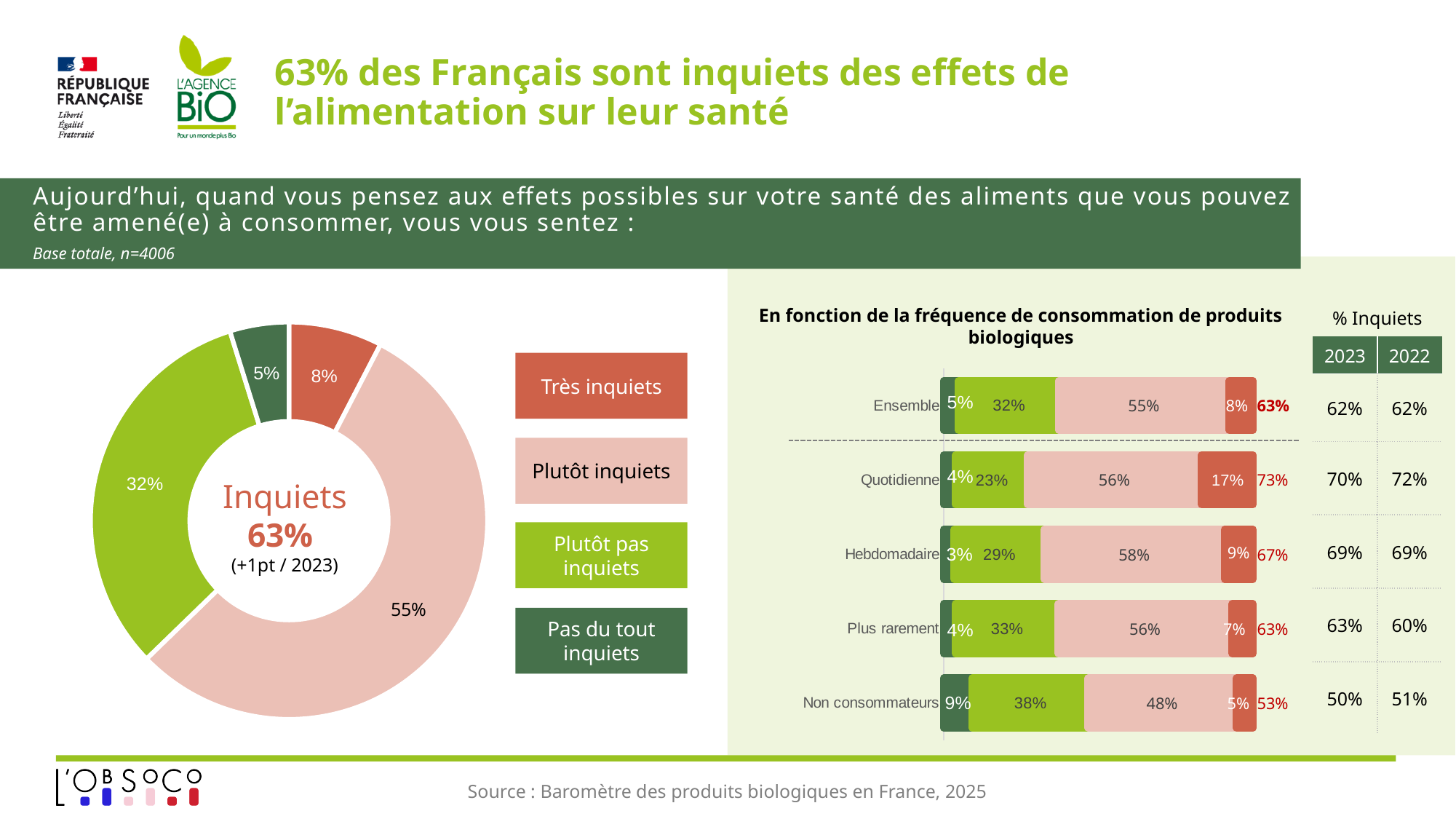
In the donut chart on the left, what share of respondents are 'Plutôt inquiets'? 55% In the donut chart on the left, what share of respondents are 'Pas du tout inquiets'? 5% In the stacked bar chart on the right, what is the 'Très inquiets' value for 'Quotidienne'? 17% In the stacked bar chart on the right, which category has the highest total '% Inquiets' (red figure)? Quotidienne What kind of chart is shown on the left side of the slide? Donut (pie) chart In the donut chart on the left, which category has the largest share? Plutôt inquiets In the stacked bar chart on the right, is the total '% Inquiets' larger for 'Hebdomadaire' or for 'Non consommateurs'? Hebdomadaire What kind of chart is shown on the right side of the slide, under 'En fonction de la fréquence de consommation de produits biologiques'? Stacked bar chart In the stacked bar chart on the right, what is the 'Plutôt pas inquiets' value for 'Non consommateurs'? 38% In the stacked bar chart on the right, how many categories (rows) are plotted? 5 In the donut chart on the left, what is the difference between the 'Plutôt inquiets' share and the 'Plutôt pas inquiets' share? 23 points In the donut chart on the left, which category has the smallest share? Pas du tout inquiets